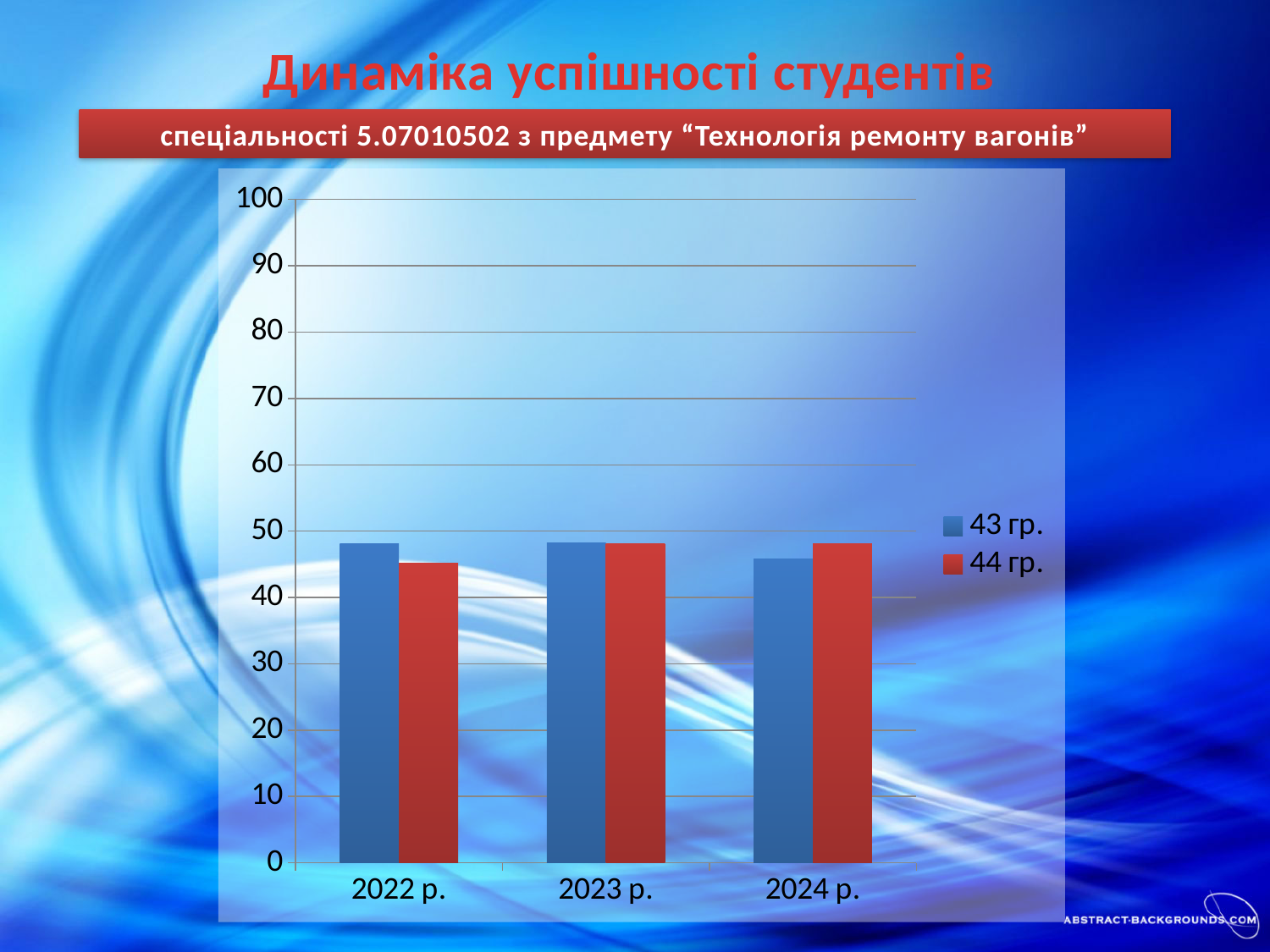
Is the value for 44 гр. in 2023 р. greater or less than 40? greater What kind of chart is shown on the slide? bar chart For the 43 гр. series, which year has the lowest value? 2024 р. In 2022 р., which series has the larger value, 43 гр. or 44 гр.? 43 гр. In 2024 р., which series has the larger value, 43 гр. or 44 гр.? 44 гр. How many year categories are shown on the x axis? 3 Which series does the legend list first? 43 гр. Is the value for 43 гр. in 2022 р. greater or less than 50? less What colour are the bars for the 44 гр. series? red Is the value for 43 гр. in 2024 р. greater or less than 50? less How many series does the legend list? 2